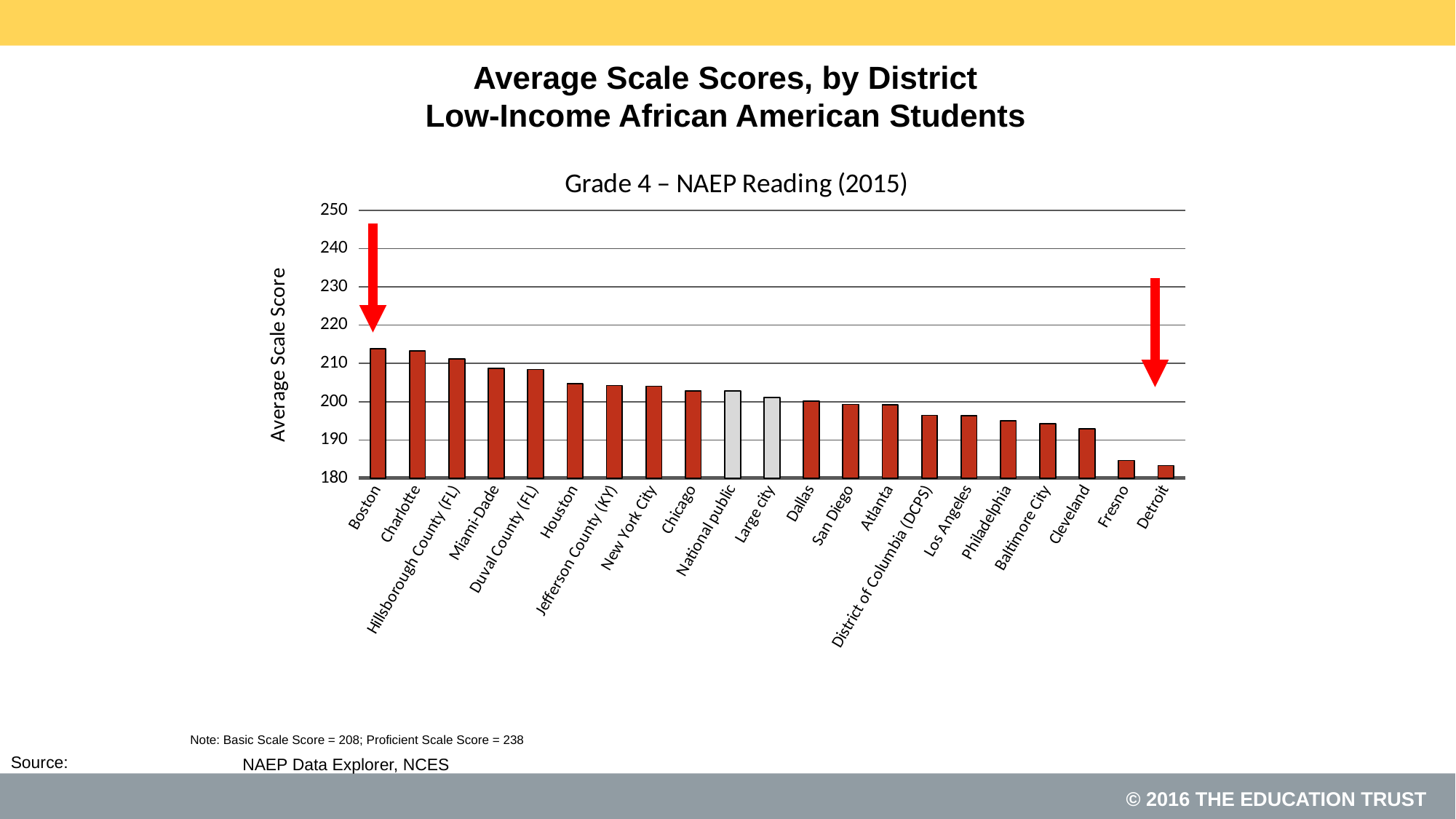
Do the values generally rise or fall moving from left to right along the x axis? Fall Is the value for Boston greater or less than 210? greater How many districts or categories are plotted along the x axis? 21 Which has a higher average scale score, Charlotte or Dallas? Charlotte Is the value for Houston greater or less than 200? greater Which category has the lowest average scale score? Detroit Is the value for Detroit greater or less than 190? less What is the label on the vertical axis? Average Scale Score What kind of chart is shown on the slide? Bar chart Which two categories are shown with grey bars instead of red? National public and Large city Which category has the highest average scale score? Boston